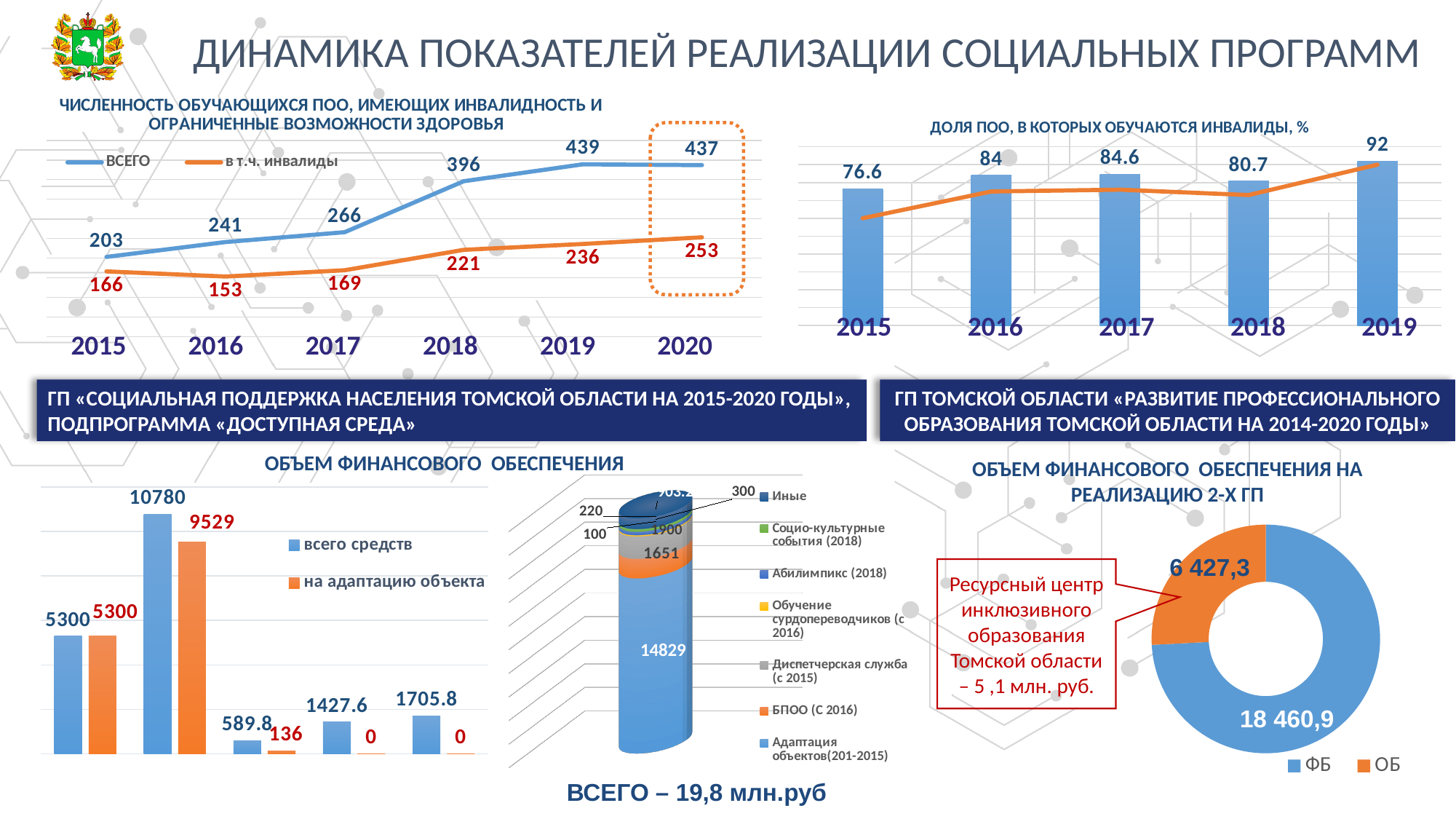
On the chart 'ДОЛЯ ПОО, В КОТОРЫХ ОБУЧАЮТСЯ ИНВАЛИДЫ, %', is the value for 2018 larger or smaller than the value for 2016? smaller On the chart 'ЧИСЛЕННОСТЬ ОБУЧАЮЩИХСЯ ПОО, ИМЕЮЩИХ ИНВАЛИДНОСТЬ И ОГРАНИЧЕННЫЕ ВОЗМОЖНОСТИ ЗДОРОВЬЯ', how many series does the legend list? 2 On the stacked bar chart in the bottom middle of the slide, how many entries does the legend list? 7 On the chart 'ЧИСЛЕННОСТЬ ОБУЧАЮЩИХСЯ ПОО, ИМЕЮЩИХ ИНВАЛИДНОСТЬ И ОГРАНИЧЕННЫЕ ВОЗМОЖНОСТИ ЗДОРОВЬЯ', what is the value of 'в т.ч. инвалиды' in 2020? 253 On the chart 'ДОЛЯ ПОО, В КОТОРЫХ ОБУЧАЮТСЯ ИНВАЛИДЫ, %', how many years are shown? 5 On the chart 'ДОЛЯ ПОО, В КОТОРЫХ ОБУЧАЮТСЯ ИНВАЛИДЫ, %', what is the value for 2017? 84.6 On the chart 'ДОЛЯ ПОО, В КОТОРЫХ ОБУЧАЮТСЯ ИНВАЛИДЫ, %', which year has the lowest value? 2015 On the donut chart 'ОБЪЕМ ФИНАНСОВОГО ОБЕСПЕЧЕНИЯ НА РЕАЛИЗАЦИЮ 2-Х ГП', what is the value for 'ОБ'? 6 427,3 On the chart 'ЧИСЛЕННОСТЬ ОБУЧАЮЩИХСЯ ПОО, ИМЕЮЩИХ ИНВАЛИДНОСТЬ И ОГРАНИЧЕННЫЕ ВОЗМОЖНОСТИ ЗДОРОВЬЯ', what is the value of 'ВСЕГО' in 2018? 396 On the chart 'ОБЪЕМ ФИНАНСОВОГО ОБЕСПЕЧЕНИЯ' (bottom left), what is the highest value of the 'всего средств' series? 10780 On the chart 'ЧИСЛЕННОСТЬ ОБУЧАЮЩИХСЯ ПОО, ИМЕЮЩИХ ИНВАЛИДНОСТЬ И ОГРАНИЧЕННЫЕ ВОЗМОЖНОСТИ ЗДОРОВЬЯ', what is the difference between 'ВСЕГО' and 'в т.ч. инвалиды' in 2019? 203 On the chart 'ЧИСЛЕННОСТЬ ОБУЧАЮЩИХСЯ ПОО, ИМЕЮЩИХ ИНВАЛИДНОСТЬ И ОГРАНИЧЕННЫЕ ВОЗМОЖНОСТИ ЗДОРОВЬЯ', in which year is the 'ВСЕГО' series highest? 2019